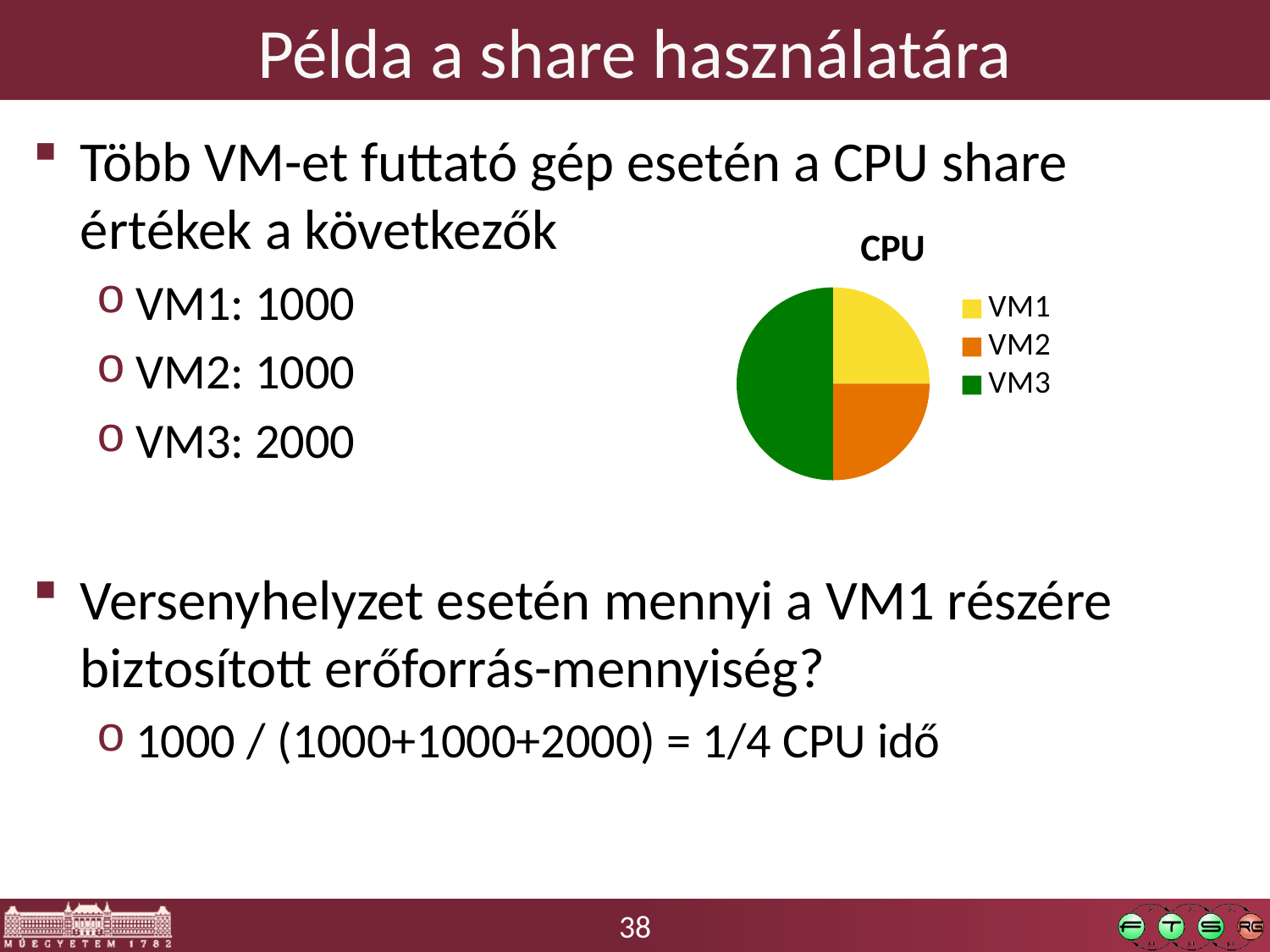
How many slices does the pie chart have? 3 What is the CPU share value for VM1? 1000 What share of the CPU pie does VM1 represent? 1/4 What is the CPU share value for VM3? 2000 What kind of chart is shown on the slide? pie chart Which slice is larger, VM3 or VM2? VM3 Which VM has the largest slice of the CPU pie chart? VM3 What is the title of the chart? CPU Which slice is larger, VM3 or VM1? VM3 How many entries does the chart legend list? 3 What colour is the VM3 slice in the pie chart? green What is the difference between the CPU share values of VM3 and VM2? 1000